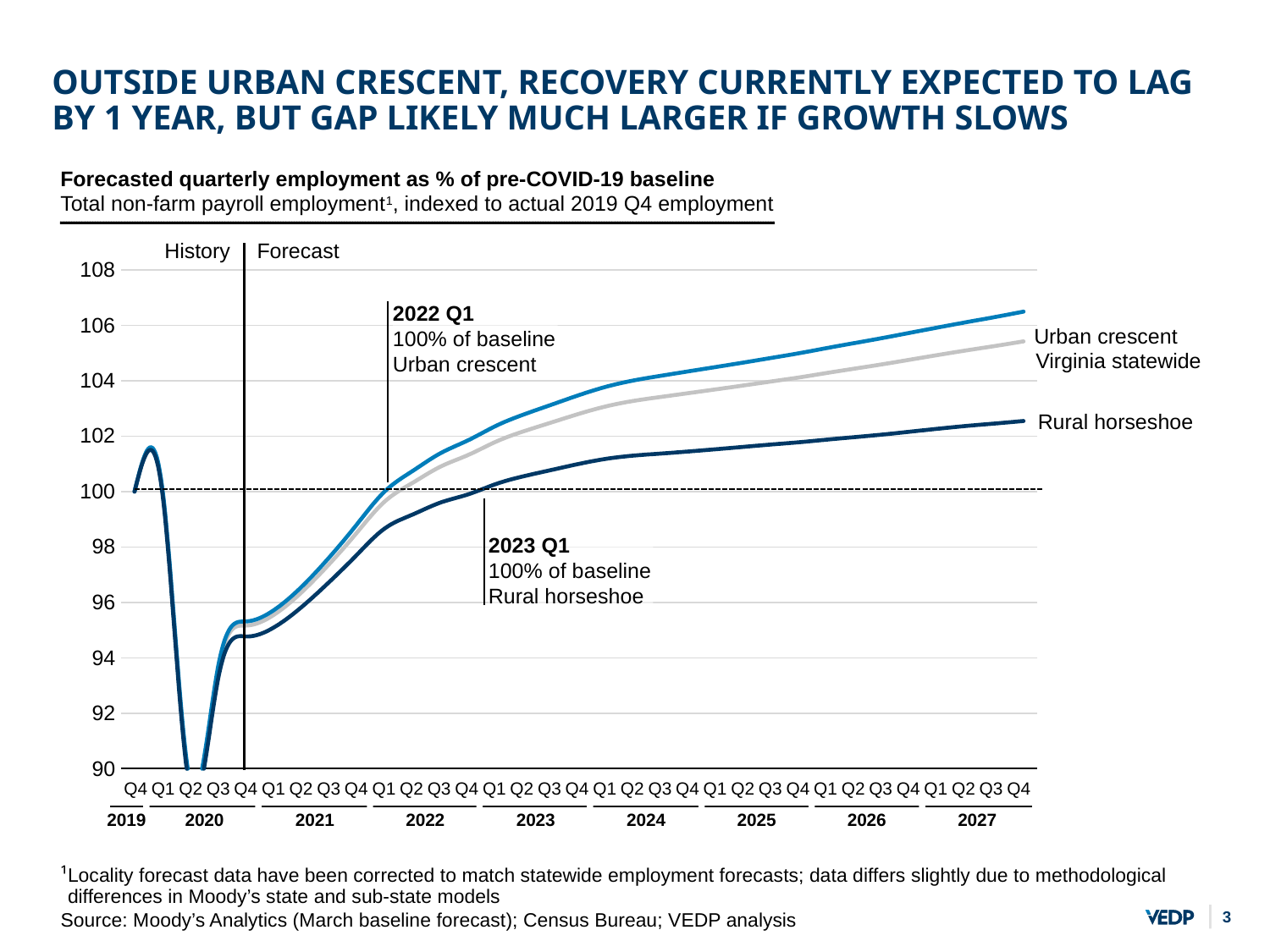
At 2025 Q1, which is larger: Urban crescent or Rural horseshoe? Urban crescent How many series are plotted on the chart? 3 Which series has the highest value at 2027 Q4? Urban crescent In which quarter do all three series reach their lowest point? 2020 Q2 In which quarter does the Urban crescent series reach 100% of baseline, according to the annotation? 2022 Q1 What kind of chart is shown on the slide? Line chart What is the chart's title? Forecasted quarterly employment as % of pre-COVID-19 baseline Is the value for Virginia statewide at 2027 Q4 greater or less than 106? less Do the series rise or fall along the x axis from 2021 Q1 to 2027 Q4? Rise In which quarter does the Rural horseshoe series reach 100% of baseline, according to the annotation? 2023 Q1 Which series has the lowest value at 2027 Q4? Rural horseshoe Is the value for Rural horseshoe at 2027 Q4 greater or less than 102? greater